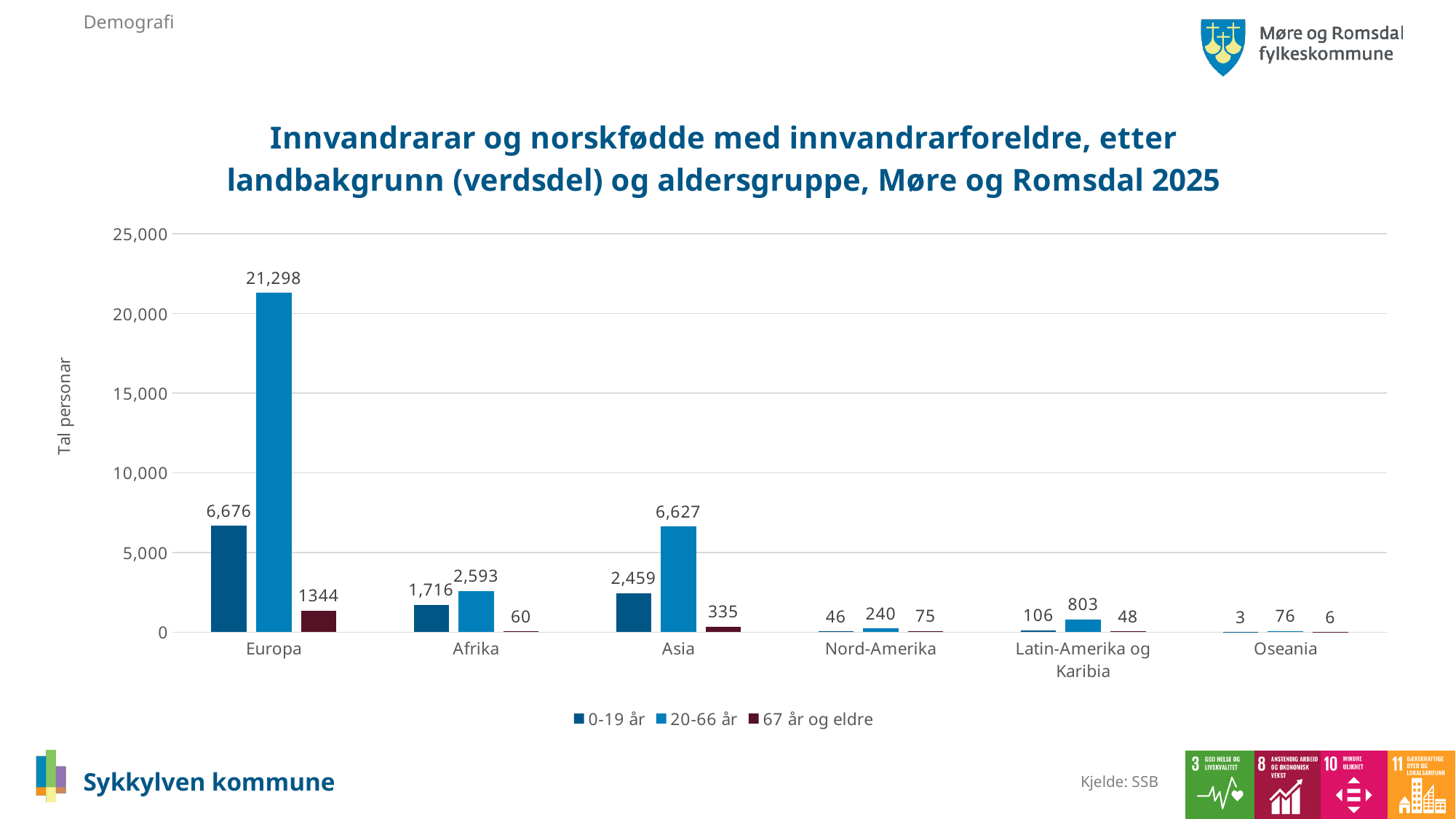
What is the value for Asia in the 0-19 år series? 2,459 Which category has the highest value in the 20-66 år series? Europa What is the label of the y axis? Tal personar What is the value for Europa in the 20-66 år series? 21,298 How many categories are shown on the x axis? 6 What is the value for Latin-Amerika og Karibia in the 67 år og eldre series? 48 How many series does the legend list? 3 What kind of chart is shown on the slide? bar chart What is the difference between the 0-19 år values for Europa and Asia? 4,217 Which category has the lowest value in the 0-19 år series? Oseania Which is larger: the 20-66 år value for Afrika or the 20-66 år value for Latin-Amerika og Karibia? Afrika Is the value for Europa in the 20-66 år series greater or less than 20,000? greater